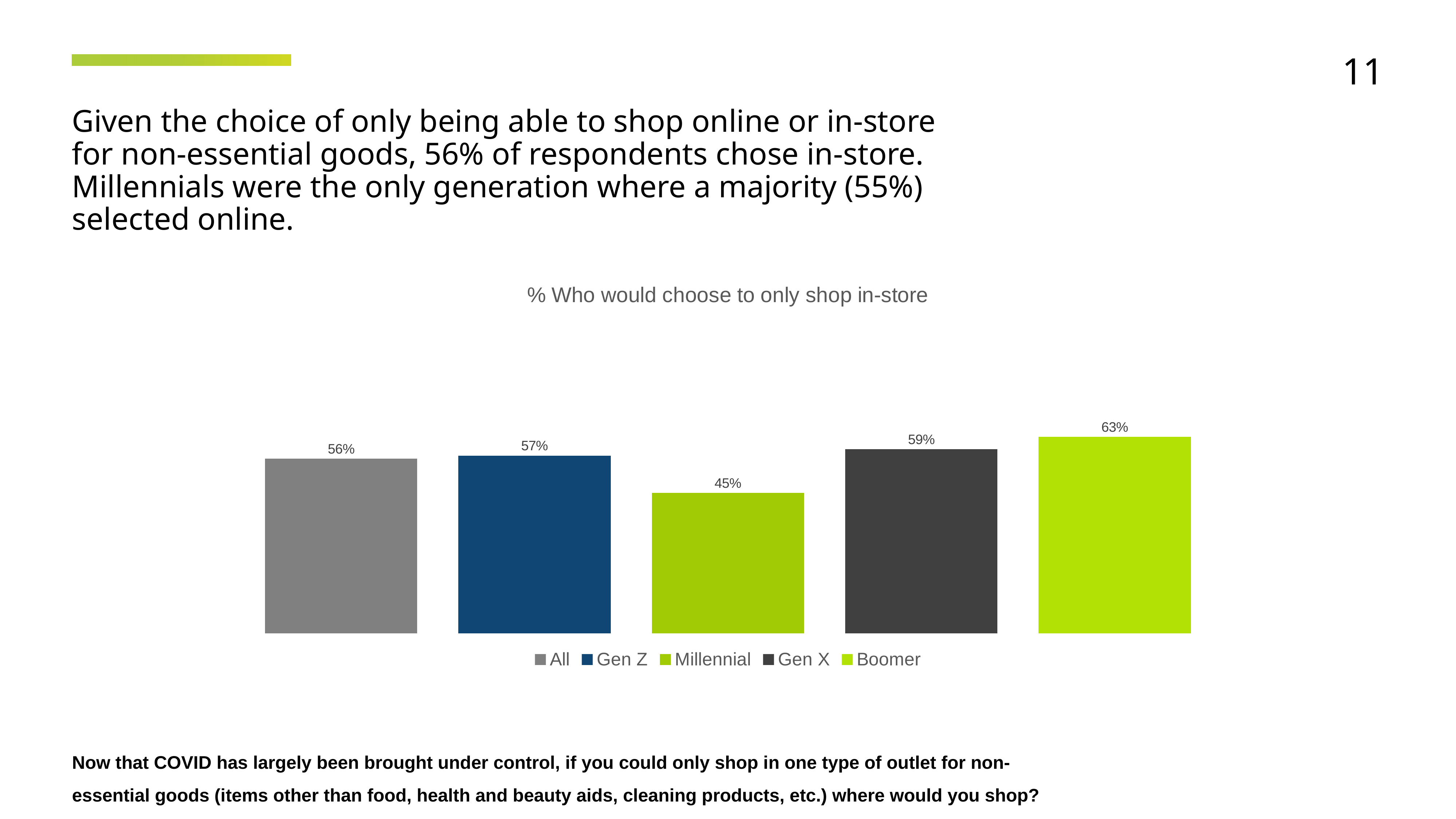
What is the difference between the Gen X value and the Gen Z value? 2% Which is larger, the value for Gen X or the value for Millennial? Gen X What is the difference between the Boomer value and the Millennial value? 18% What is the title of the chart? % Who would choose to only shop in-store What is the value for Millennial in the chart? 45% What is the value for All in the chart? 56% Which group has the lowest value in the chart? Millennial Which group has the highest value in the chart? Boomer What is the value for Gen X in the chart? 59% What kind of chart is shown on the slide? Bar chart What is the value for Boomer in the chart? 63% How many bars are shown in the chart? 5